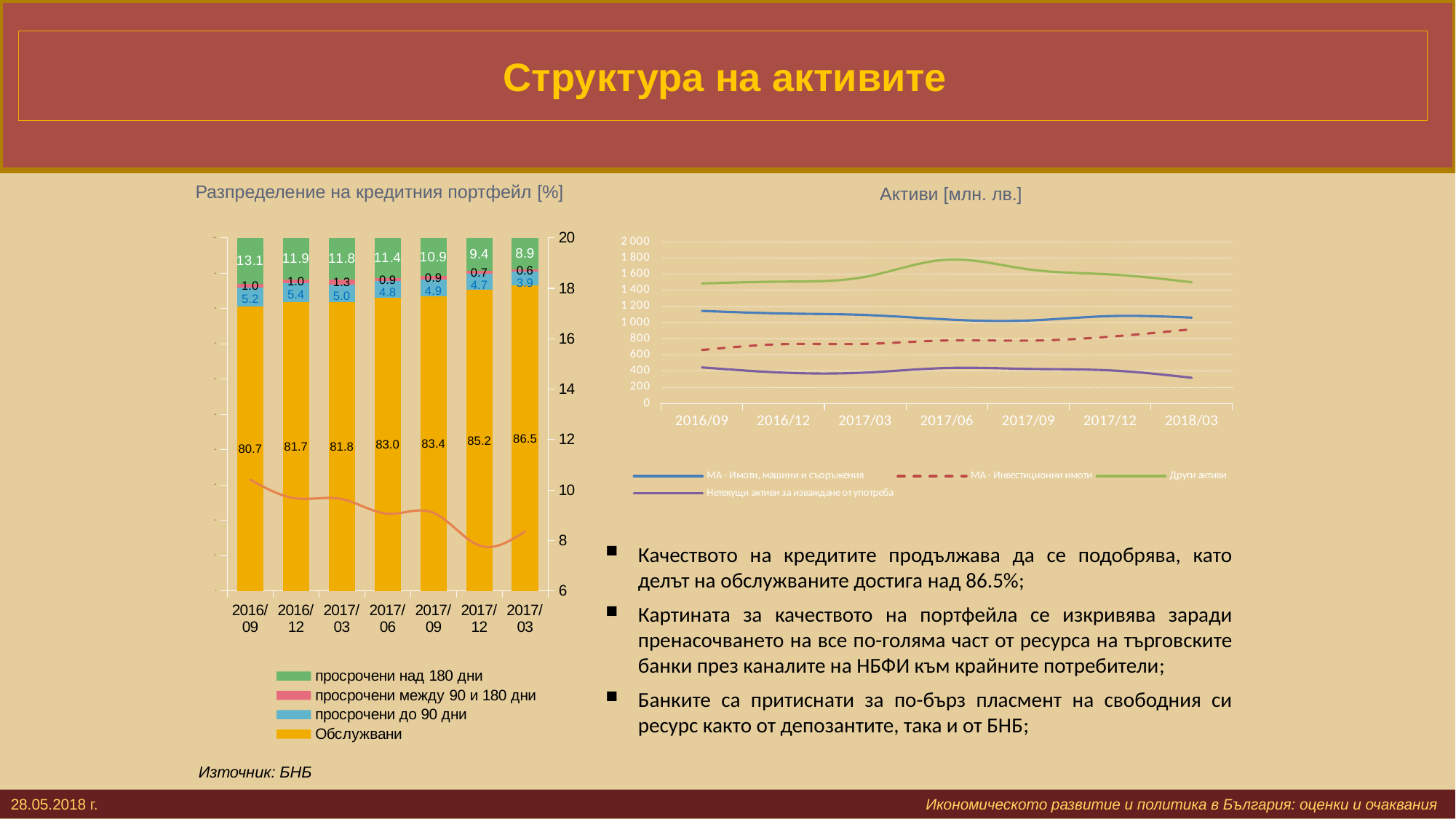
In the chart 'Разпределение на кредитния портфейл [%]', in which period is the Обслужвани share highest? The last period (rightmost bar), 86.5 In the chart 'Разпределение на кредитния портфейл [%]', in which period is 'просрочени над 180 дни' lowest? The last period (rightmost bar), 8.9 In the chart 'Разпределение на кредитния портфейл [%]', what is the value for 'просрочени до 90 дни' in 2017/12? 4.7 How many series does the legend of the chart 'Разпределение на кредитния портфейл [%]' list? 4 In the chart 'Разпределение на кредитния портфейл [%]', does the Обслужвани share rise or fall across the periods? Rise In the chart 'Активи [млн. лв.]', is the value for 'Нетекущи активи за изваждане от употреба' in 2018/03 greater or less than 400? less In the chart 'Активи [млн. лв.]', is the value for 'Други активи' in 2017/06 greater or less than 1 600? greater In the chart 'Разпределение на кредитния портфейл [%]', what is the value for 'просрочени над 180 дни' in 2017/06? 11.4 In the chart 'Разпределение на кредитния портфейл [%]', what is the difference between the Обслужвани values in 2017/12 and 2016/09? 4.5 In the chart 'Разпределение на кредитния портфейл [%]', what is the value for Обслужвани in 2016/09? 80.7 What kind of chart is 'Активи [млн. лв.]'? Line chart How many periods are shown on the x axis of the chart 'Активи [млн. лв.]'? 7